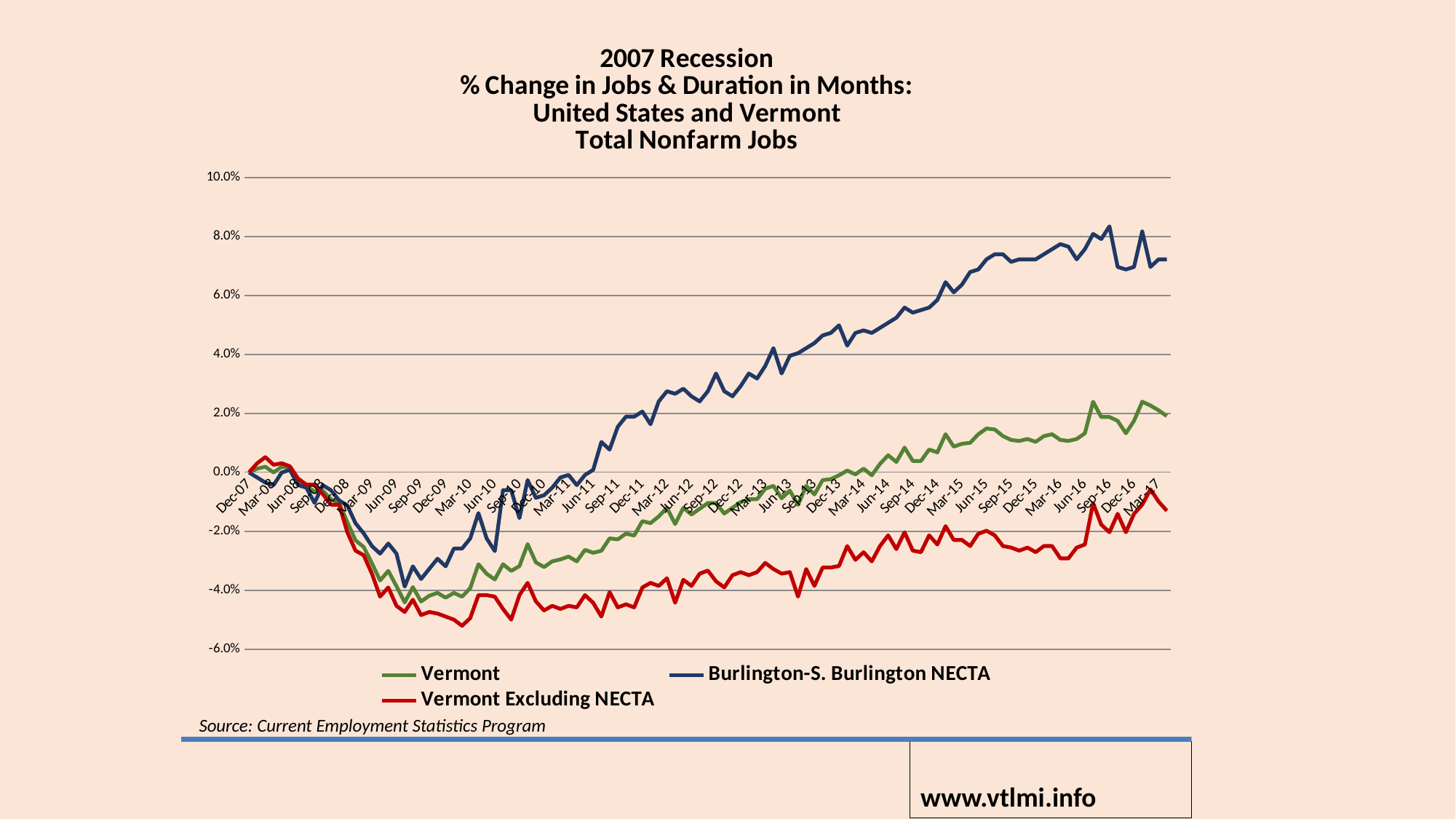
Is the value for Vermont Excluding NECTA at Mar-10 greater or less than -4.0%? less How many series does the legend list? 3 Does the Burlington-S. Burlington NECTA line rise or fall from Mar-11 to Mar-16? rise At Mar-12, which is larger: the value for Vermont or the value for Vermont Excluding NECTA? Vermont What kind of chart is shown on the slide? Line chart Is the value for Vermont Excluding NECTA at Mar-17 greater or less than 0.0%? less Is the value for Burlington-S. Burlington NECTA at Dec-16 greater or less than 6.0%? greater Which series is lowest at Mar-17? Vermont Excluding NECTA Which series is drawn in green? Vermont Which series is highest at Mar-17? Burlington-S. Burlington NECTA Does the Vermont Excluding NECTA line rise or fall from Dec-07 to Mar-10? fall